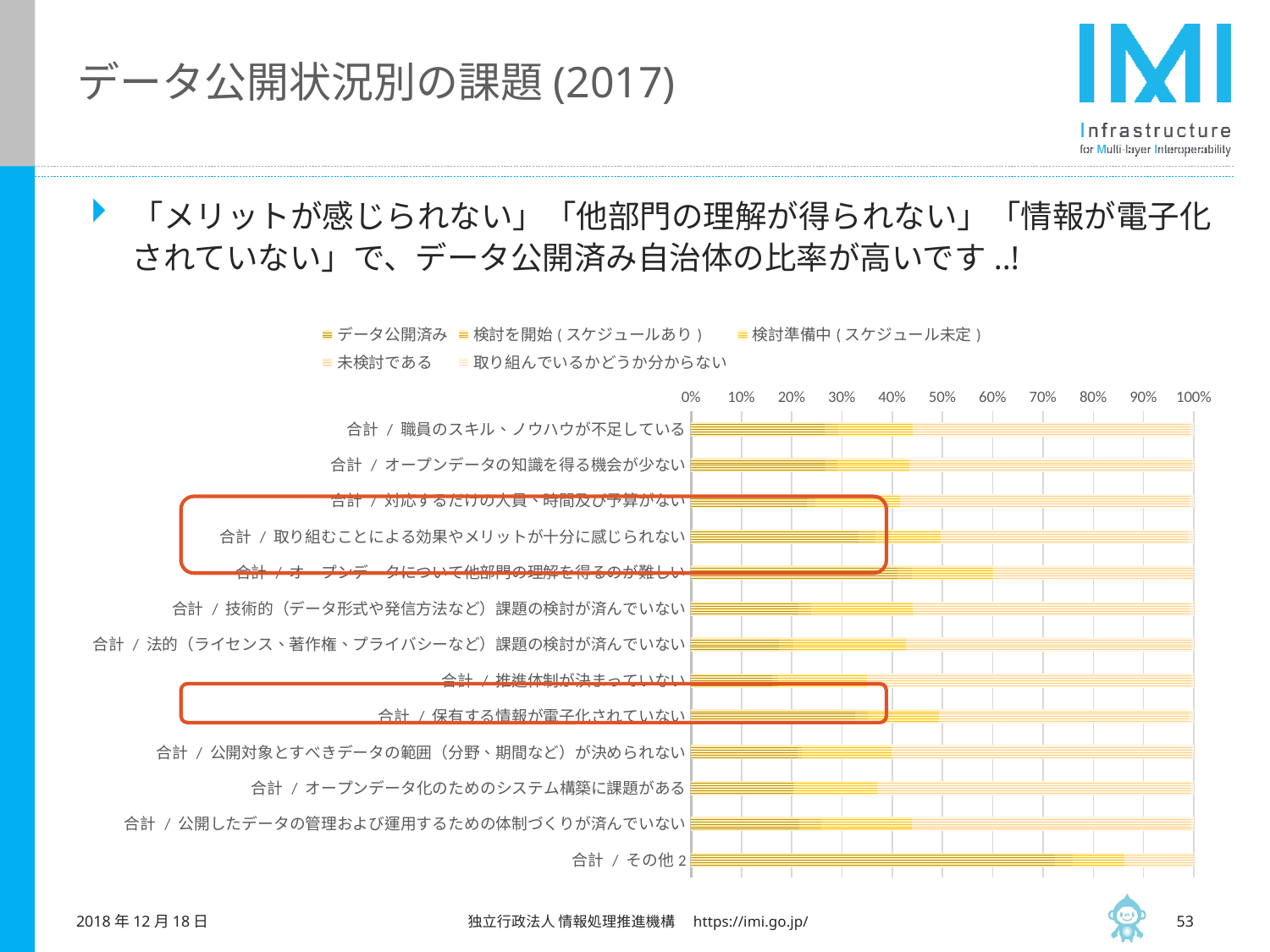
What is the maximum value shown on the horizontal axis of the chart? 100% What is the interval between tick marks on the horizontal axis of the chart? 10% What is the first series listed in the chart legend? データ公開済み What is the label of the last category at the bottom of the chart? 合計 / その他 2 How many categories (bars) are plotted in the chart? 13 What is the last series listed in the chart legend? 取り組んでいるかどうか分からない Is the データ公開済み share for 合計 / 取り組むことによる効果やメリットが十分に感じられない greater or less than 30%? greater What kind of chart is shown on the slide? Stacked bar chart Is the データ公開済み share for 合計 / 推進体制が決まっていない greater or less than 30%? less How many series does the legend of the chart list? 5